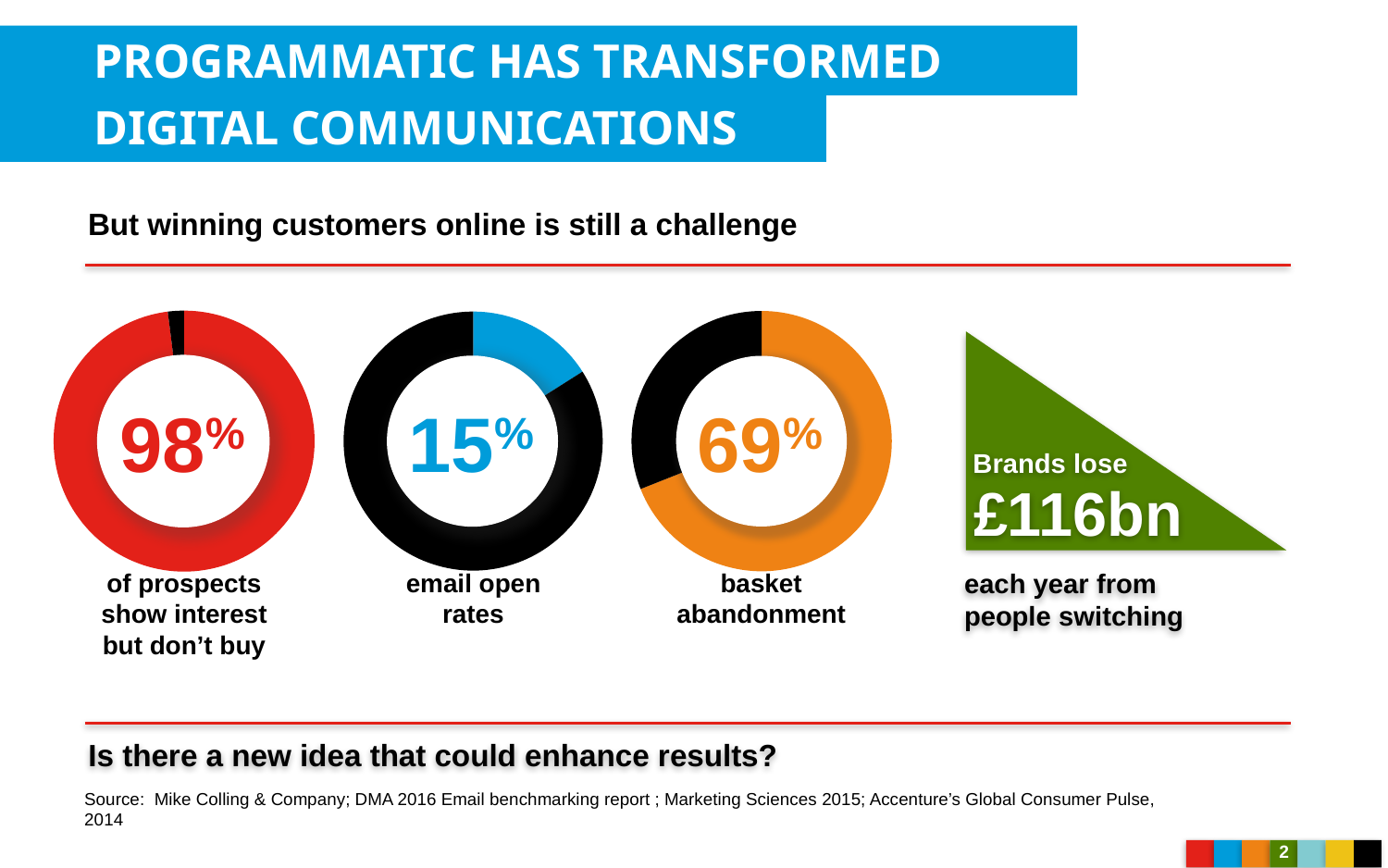
According to the green triangle graphic, how much do brands lose each year from people switching? £116bn What is the difference between the basket abandonment rate and the email open rate? 54 percentage points Which of the three donut charts shows the lowest percentage? Email open rates (15%) What value does the middle donut chart show for email open rates? 15% What value does the right donut chart show for basket abandonment? 69% What percentage is shown in the left donut chart for prospects who show interest but don't buy? 98% Which is larger: the email open rate or the basket abandonment rate? Basket abandonment rate Which of the three donut charts shows the highest percentage? Prospects who show interest but don't buy (98%) How many donut charts are shown on the slide? 3 What is the difference between the share of prospects who show interest but don't buy and the basket abandonment rate? 29 percentage points What kind of charts are used to display the 98%, 15% and 69% figures? Donut (pie) charts What colour is the highlighted slice in the basket abandonment donut chart? Orange